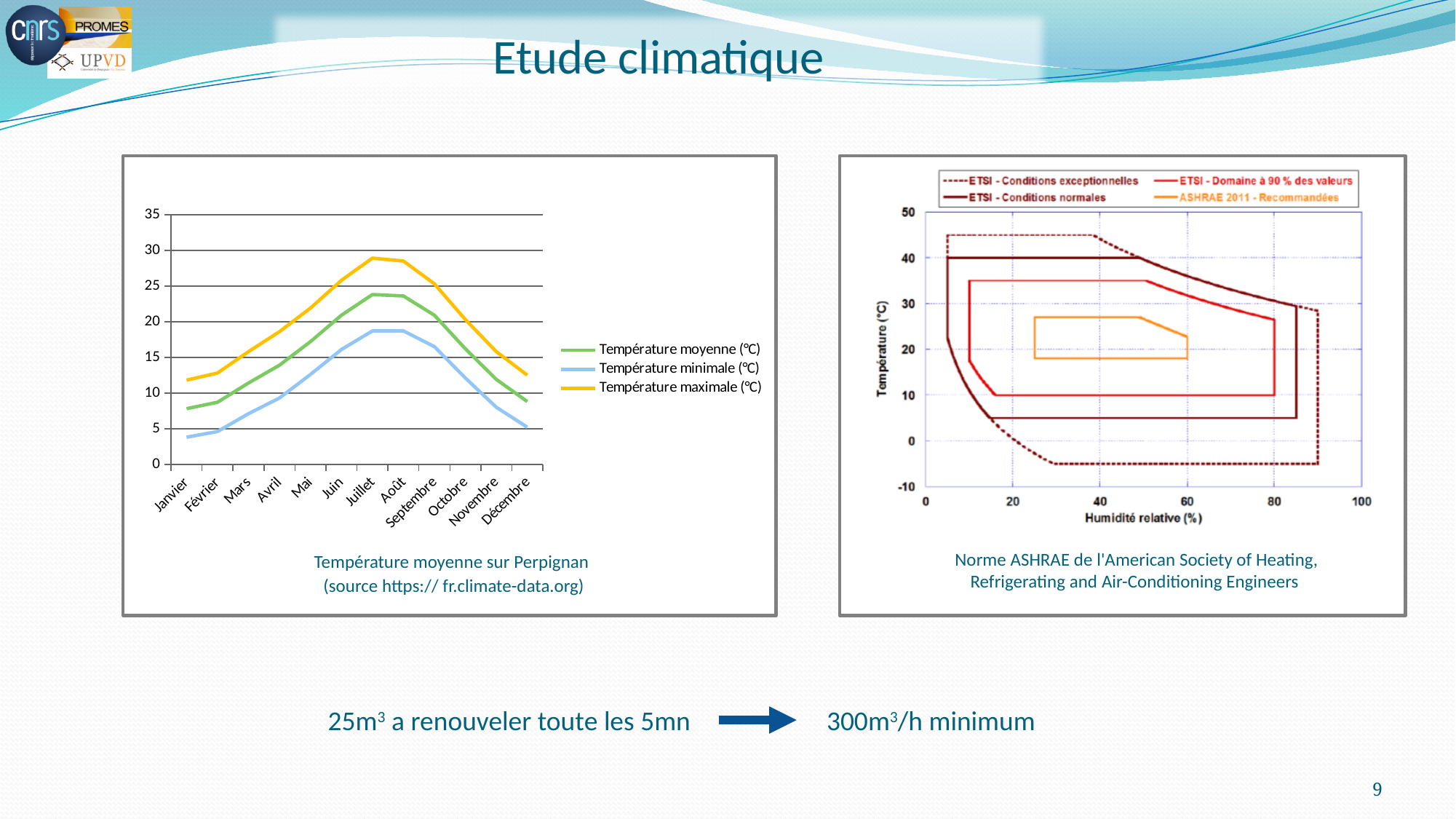
In the left chart 'Température moyenne sur Perpignan', which month has the lowest Température minimale (°C)? Janvier In the left chart 'Température moyenne sur Perpignan', is the value of Température moyenne (°C) for Juillet greater or less than 20? greater In the left chart 'Température moyenne sur Perpignan', is the value of Température minimale (°C) for Janvier greater or less than 5? less In the right chart 'Norme ASHRAE', how many entries does the legend list? 4 In the left chart 'Température moyenne sur Perpignan', how many months are shown on the x axis? 12 In the left chart 'Température moyenne sur Perpignan', which colour is used for the Température maximale (°C) series? yellow In the left chart 'Température moyenne sur Perpignan', do the Température moyenne (°C) values rise or fall from Janvier to Juillet? rise In the left chart 'Température moyenne sur Perpignan', is the value of Température maximale (°C) for Juillet greater or less than 25? greater In the left chart 'Température moyenne sur Perpignan', which is larger: the Température maximale (°C) for Juillet or for Janvier? Juillet What kind of chart is the left chart, 'Température moyenne sur Perpignan'? line chart In the left chart 'Température moyenne sur Perpignan', how many series does the legend list? 3